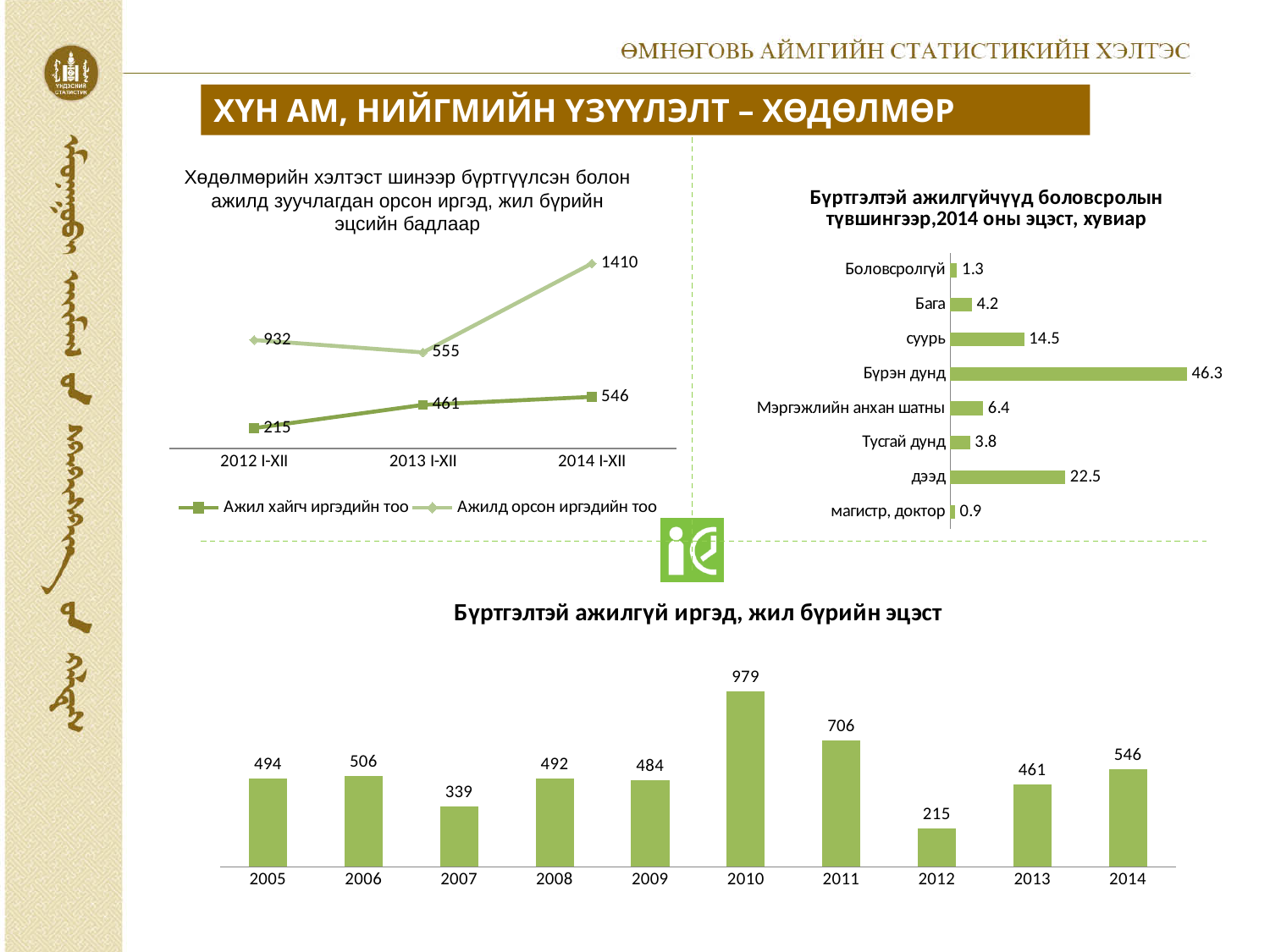
In the bottom chart 'Бүртгэлтэй ажилгүй иргэд, жил бүрийн эцэст', which year has the highest value? 2010 In the bottom chart 'Бүртгэлтэй ажилгүй иргэд, жил бүрийн эцэст', what is the value for 2010? 979 In the top-right chart 'Бүртгэлтэй ажилгүйчүүд боловсролын түвшингээр', what is the value for Бүрэн дунд? 46.3 In the top-right chart 'Бүртгэлтэй ажилгүйчүүд боловсролын түвшингээр', which category has the lowest value? магистр, доктор In the top-left line chart, does the series 'Ажил хайгч иргэдийн тоо' rise or fall from 2012 I-XII to 2014 I-XII? rise In the top-left line chart, what is the value of 'Ажилд орсон иргэдийн тоо' for 2014 I-XII? 1410 What kind of chart is the top-right chart 'Бүртгэлтэй ажилгүйчүүд боловсролын түвшингээр'? bar chart In the bottom chart 'Бүртгэлтэй ажилгүй иргэд, жил бүрийн эцэст', how many years are shown? 10 In the top-right chart 'Бүртгэлтэй ажилгүйчүүд боловсролын түвшингээр', which is larger: дээд or суурь? дээд In the top-left line chart, how many series does the legend list? 2 In the bottom chart 'Бүртгэлтэй ажилгүй иргэд, жил бүрийн эцэст', which year has the lowest value? 2012 In the bottom chart 'Бүртгэлтэй ажилгүй иргэд, жил бүрийн эцэст', what is the difference between the values for 2011 and 2012? 491